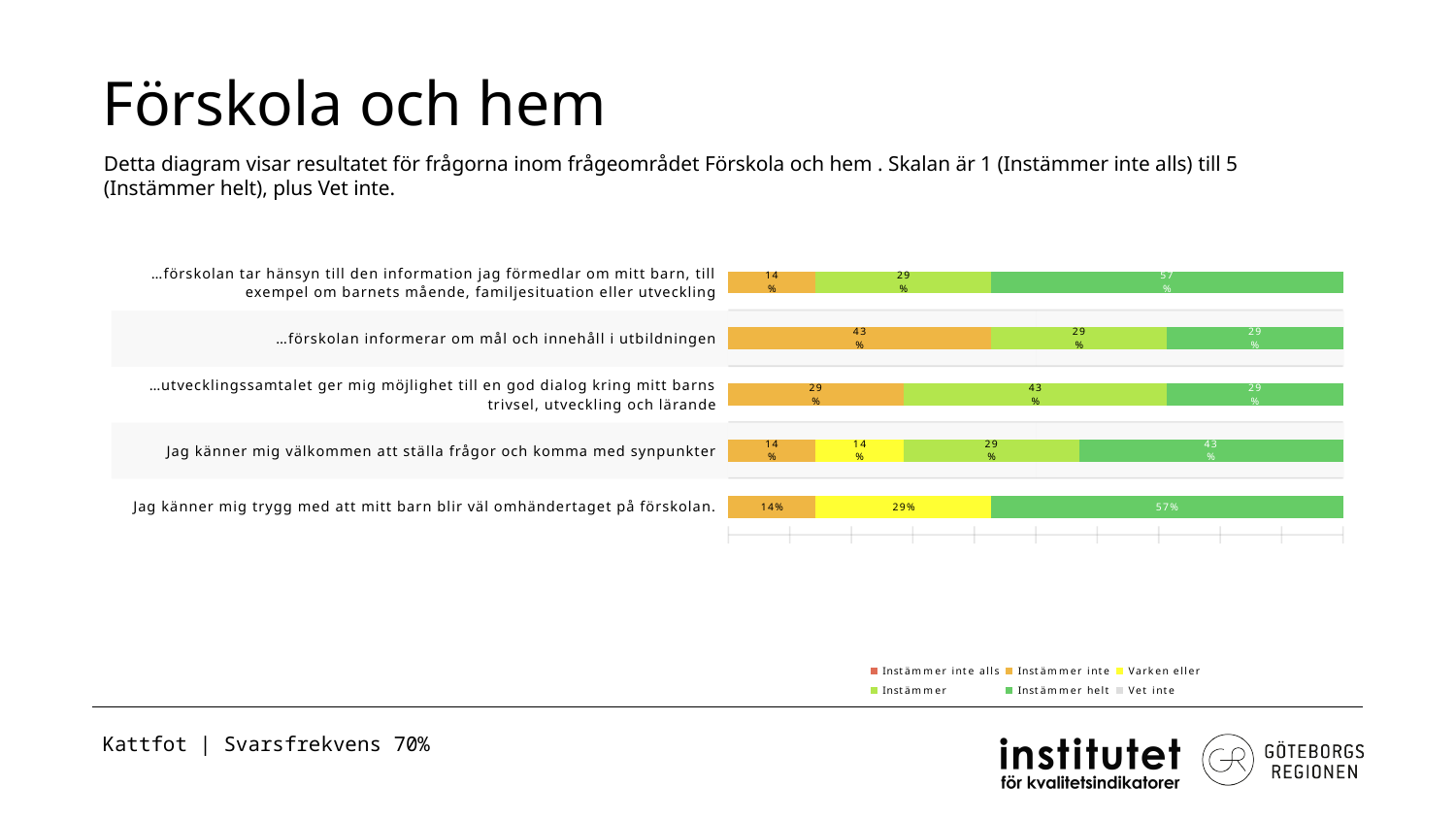
What is the total of the labelled segments for 'Jag känner mig välkommen att ställa frågor och komma med synpunkter'? 100% What is the 'Instämmer' value for '…utvecklingssamtalet ger mig möjlighet till en god dialog kring mitt barns trivsel, utveckling och lärande'? 43% Which category has the highest 'Instämmer inte' value? …förskolan informerar om mål och innehåll i utbildningen What is the difference between the 'Instämmer helt' value for '…förskolan tar hänsyn till den information jag förmedlar om mitt barn…' and for '…förskolan informerar om mål och innehåll i utbildningen'? 28% Which is larger: the 'Instämmer helt' value for 'Jag känner mig välkommen att ställa frågor och komma med synpunkter' or for '…utvecklingssamtalet ger mig möjlighet till en god dialog…'? Jag känner mig välkommen att ställa frågor och komma med synpunkter What is the 'Instämmer helt' value for 'Jag känner mig trygg med att mitt barn blir väl omhändertaget på förskolan'? 57% What is the title of the slide containing the chart? Förskola och hem What is the 'Instämmer inte' value for '…förskolan informerar om mål och innehåll i utbildningen'? 43% How many question categories are plotted in the chart? 5 What is the 'Varken eller' value for 'Jag känner mig välkommen att ställa frågor och komma med synpunkter'? 14% What kind of chart is shown on the slide? Stacked bar chart How many series does the legend list? 6